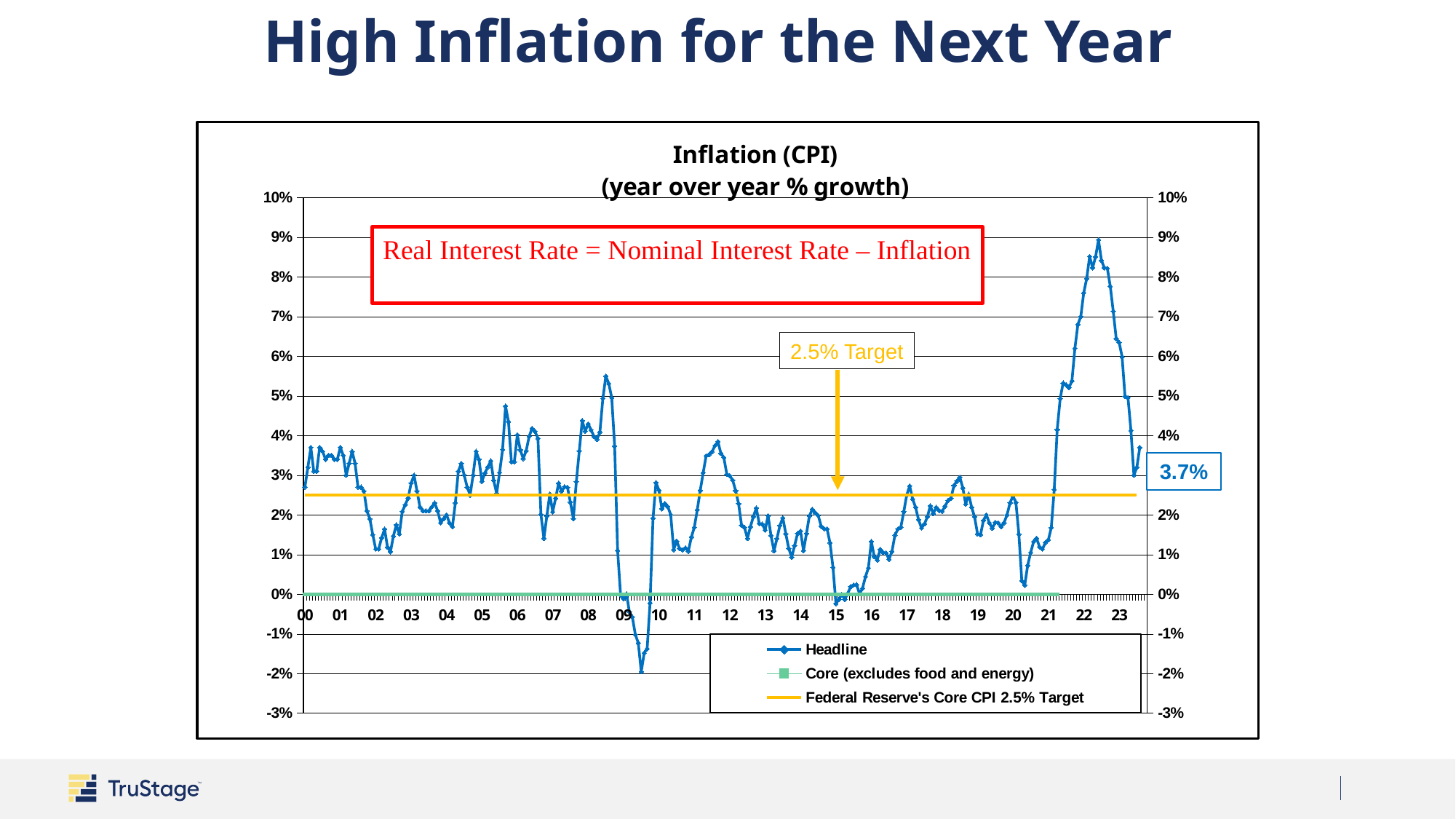
What value is the Federal Reserve's Core CPI target line set at? 2.5% In which year does the Headline series reach its highest value? 2022 What is the most recent Headline inflation value labeled on the chart? 3.7% Which is larger: the Headline peak in 2008 or the Headline peak in 2022? 2022 Is the lowest Headline inflation value in 2009 greater or less than -1%? less In which year does the Headline series reach its lowest value? 2009 Is the peak Headline inflation value in 2022 greater or less than 8%? greater Is the latest labeled Headline value of 3.7% greater or less than the 2.5% target? greater What kind of chart is shown on the slide? line chart What is the title of the chart? Inflation (CPI) (year over year % growth) How many series does the legend list? 3 What is the full legend label for the Core series? Core (excludes food and energy)